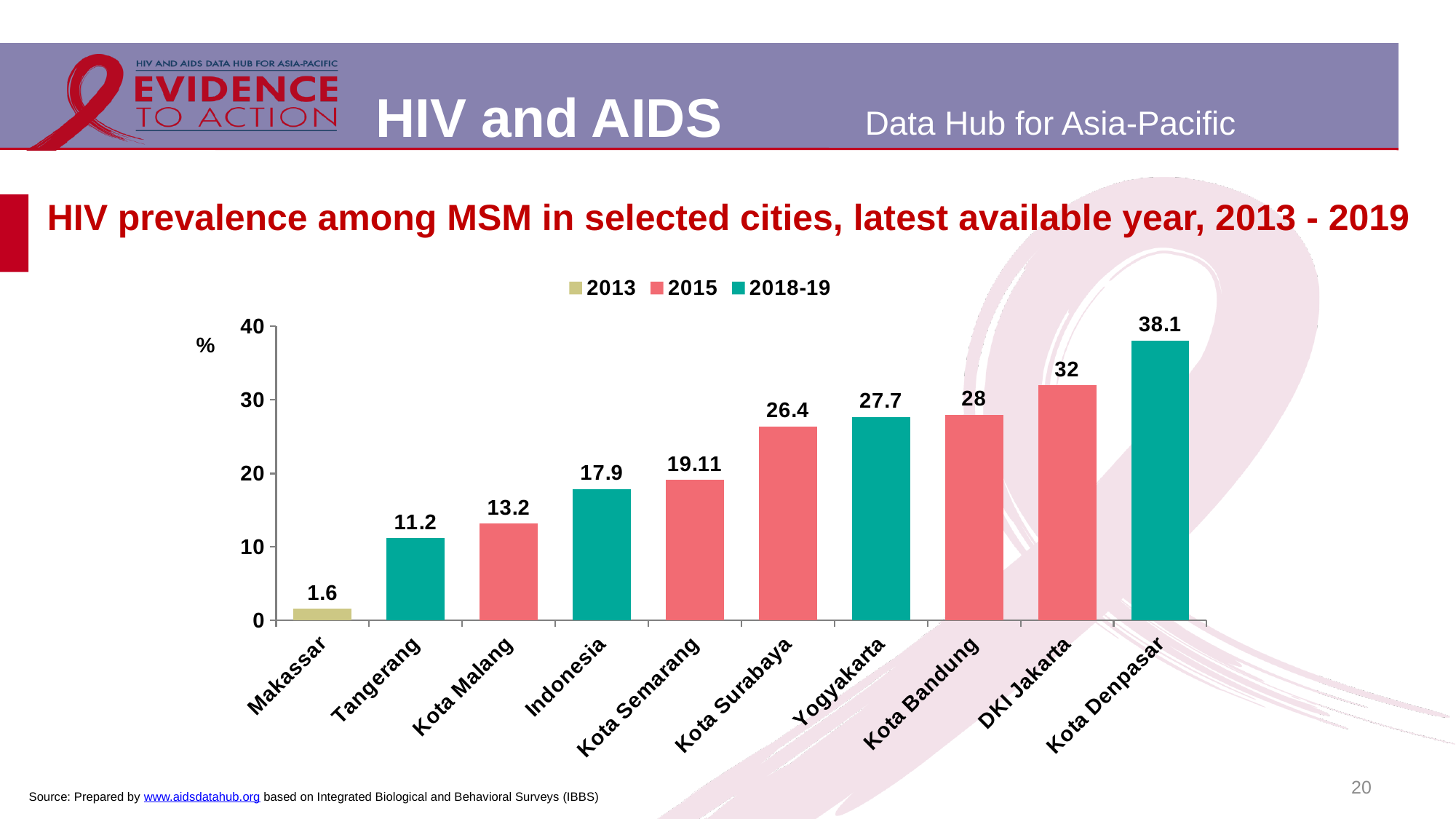
What is the HIV prevalence among MSM in Kota Semarang? 19.11 Which city has the highest HIV prevalence among MSM on the chart? Kota Denpasar Is the value for Indonesia greater or less than 20? less Which has a higher HIV prevalence among MSM, Yogyakarta or Kota Surabaya? Yogyakarta What is the difference between the HIV prevalence values for DKI Jakarta and Kota Bandung? 4 What is the HIV prevalence among MSM in Kota Denpasar? 38.1 What kind of chart is shown on the slide? bar chart How many cities or locations are shown on the x axis of the chart? 10 Which legend series does the Makassar bar belong to? 2013 What is the HIV prevalence among MSM in Makassar? 1.6 Which city has the lowest HIV prevalence among MSM on the chart? Makassar How many series does the legend list? 3